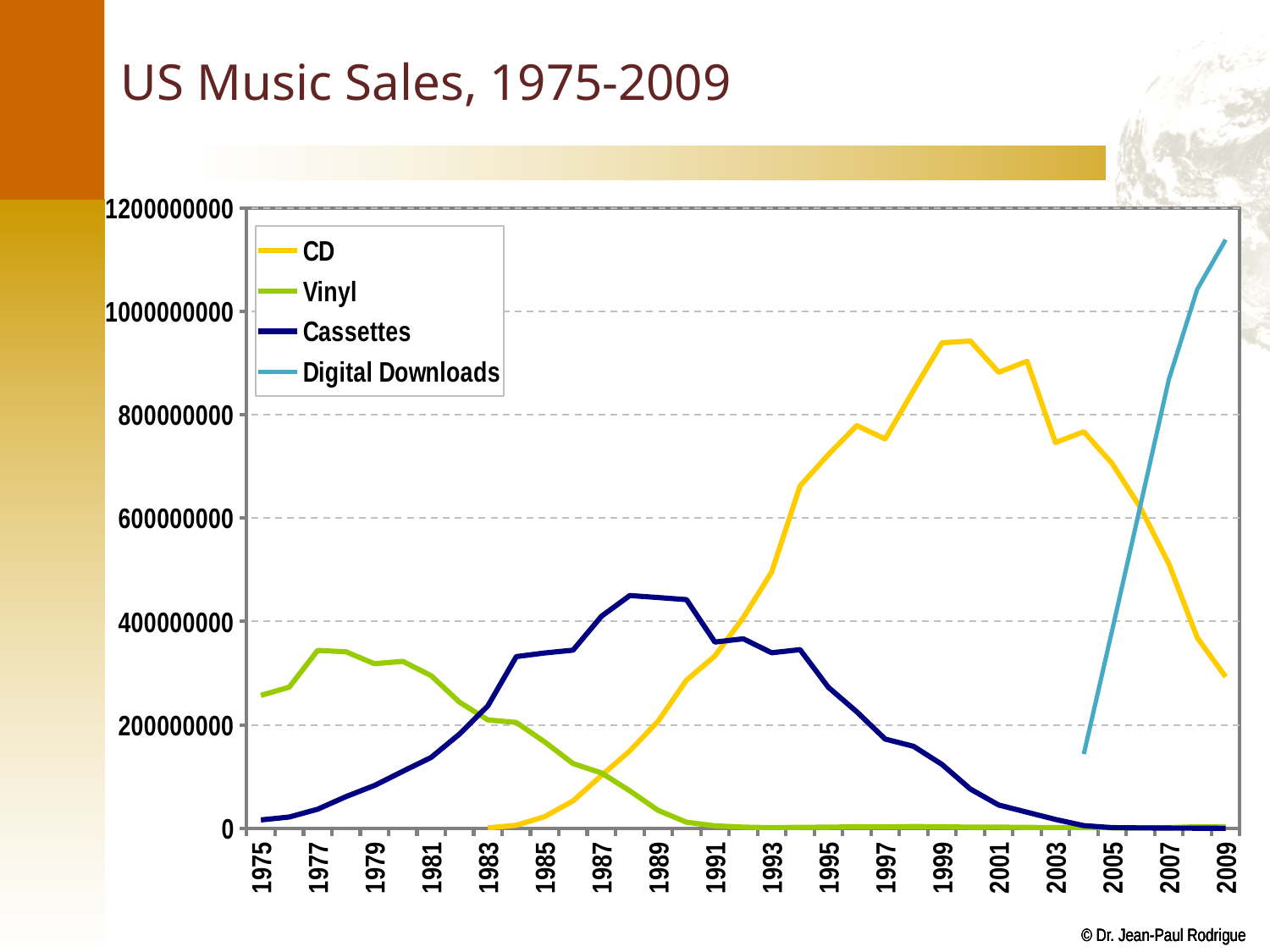
Is the value for Digital Downloads in 2009 greater or less than 1000000000? greater Which series is drawn in dark blue? Cassettes Is the value for CD in 1999 greater or less than 800000000? greater Is the value for CD in 2009 greater or less than 400000000? less What is the title of the slide's chart? US Music Sales, 1975-2009 In 1985, which is larger: Cassettes or Vinyl? Cassettes How many series does the legend list? 4 In 2009, which is larger: Digital Downloads or CD? Digital Downloads What kind of chart is shown on the slide? line chart Which series reaches the highest value anywhere on the chart? Digital Downloads Do Vinyl sales rise or fall from 1977 to 1991? fall